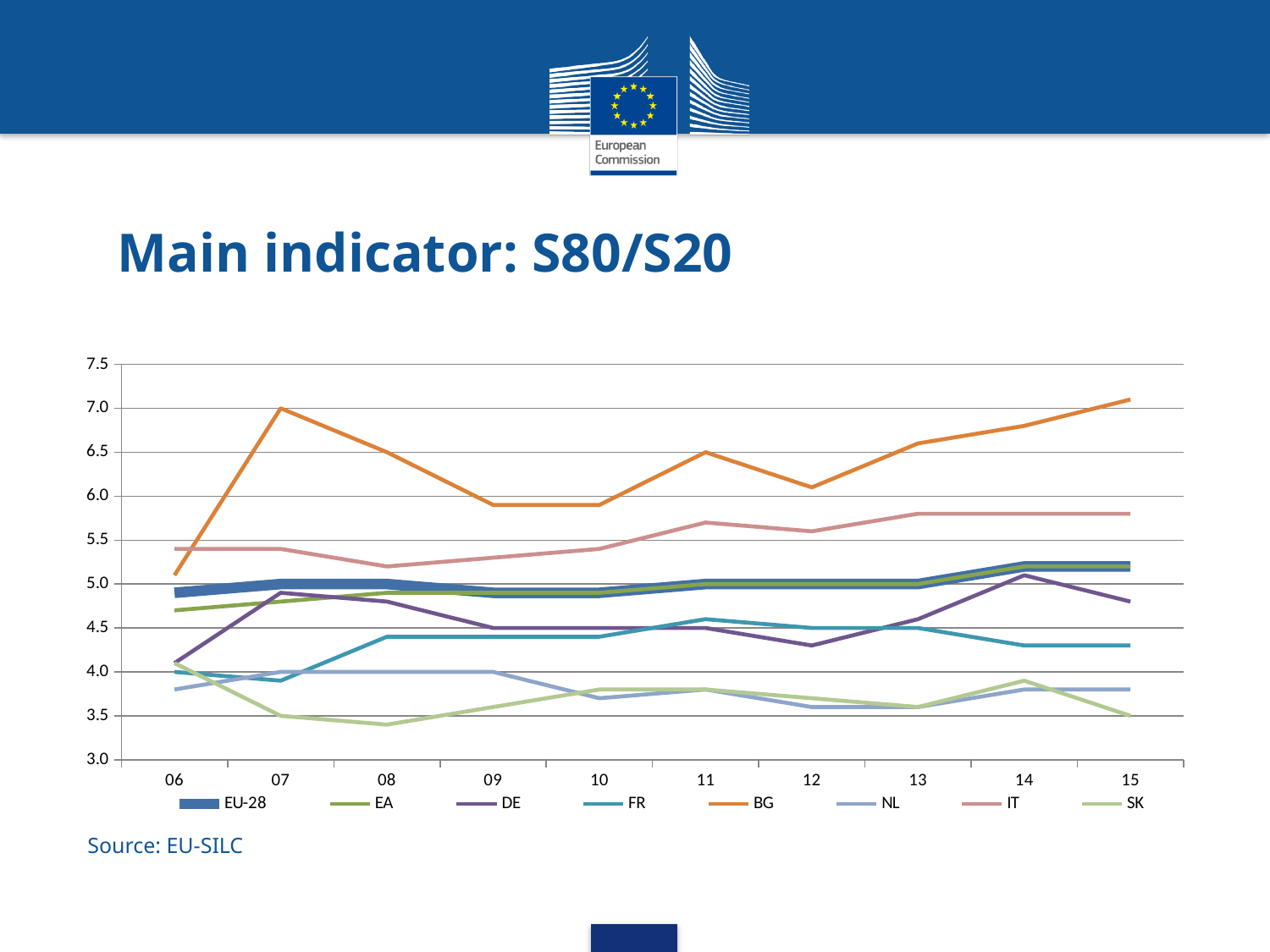
Is the value for IT in 13 greater or less than 5.5? greater Is the value for DE in 12 greater or less than 4.5? less Which series has the highest value in 15? BG Which series has the highest value in 07? BG How many years are shown along the x axis? 10 What kind of chart is shown on the slide? line chart Is the value for SK in 08 greater or less than 3.5? less Does the value for BG rise or fall from 12 to 15? rise Which is larger in 10, the value for IT or the value for FR? IT How many series does the legend list? 8 Which series has the lowest value in 15? SK